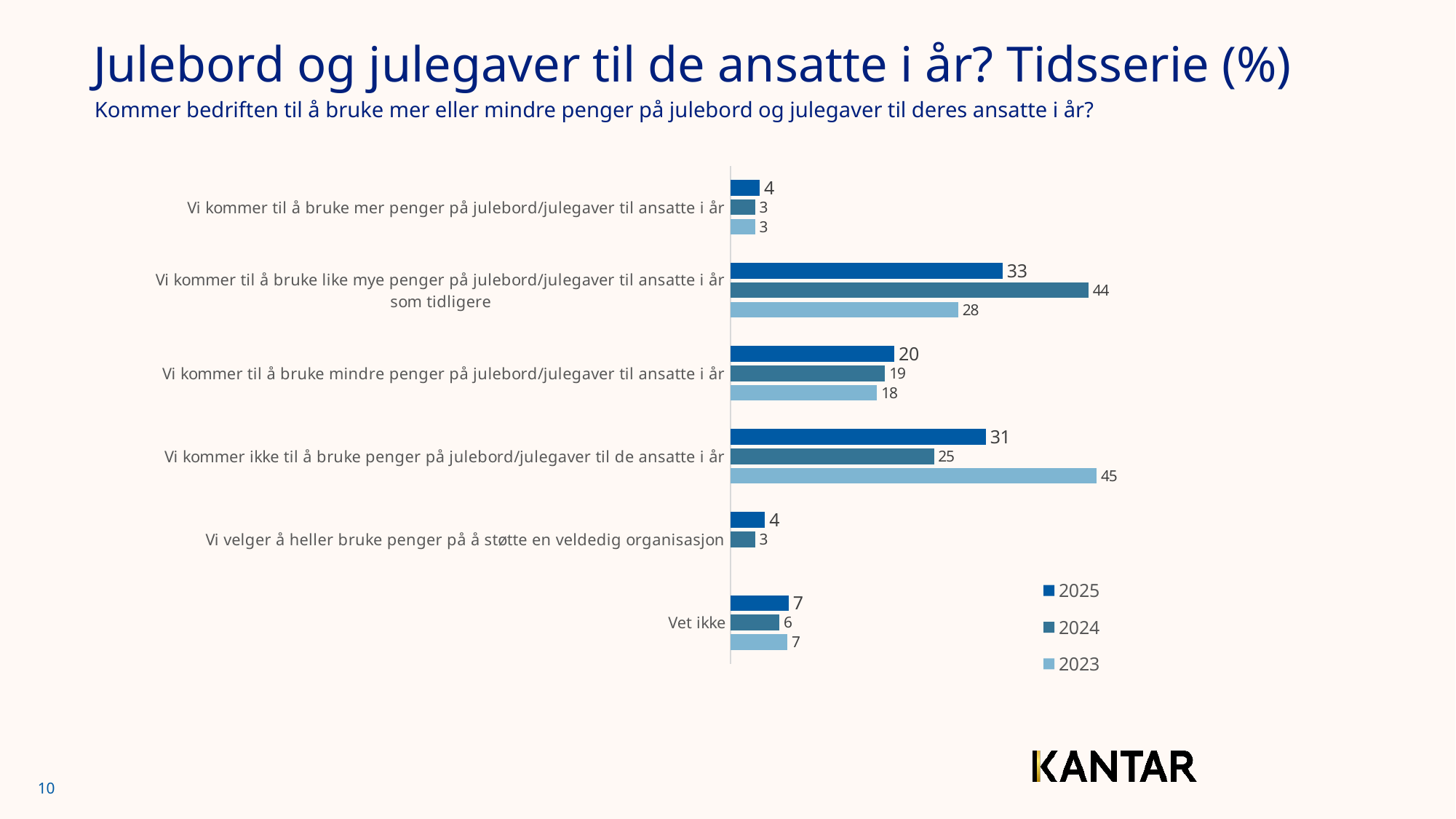
Which category has the highest 2023 value? Vi kommer ikke til å bruke penger på julebord/julegaver til de ansatte i år Which years are listed in the chart legend? 2025, 2024, 2023 Which category has the highest 2024 value? Vi kommer til å bruke like mye penger på julebord/julegaver til ansatte i år som tidligere What is the 2024 value for "Vi kommer til å bruke mindre penger på julebord/julegaver til ansatte i år"? 19 For "Vi kommer ikke til å bruke penger på julebord/julegaver til de ansatte i år", which year has the larger value, 2025 or 2024? 2025 What is the 2025 value for "Vi kommer til å bruke like mye penger på julebord/julegaver til ansatte i år som tidligere"? 33 What is the 2023 value for "Vi kommer ikke til å bruke penger på julebord/julegaver til de ansatte i år"? 45 What is the 2025 value for "Vet ikke"? 7 How many categories are shown on the chart? 6 What is the difference between the 2024 and 2023 values for "Vi kommer til å bruke like mye penger på julebord/julegaver til ansatte i år som tidligere"? 16 How many series does the legend list? 3 What kind of chart is shown on the slide? Bar chart